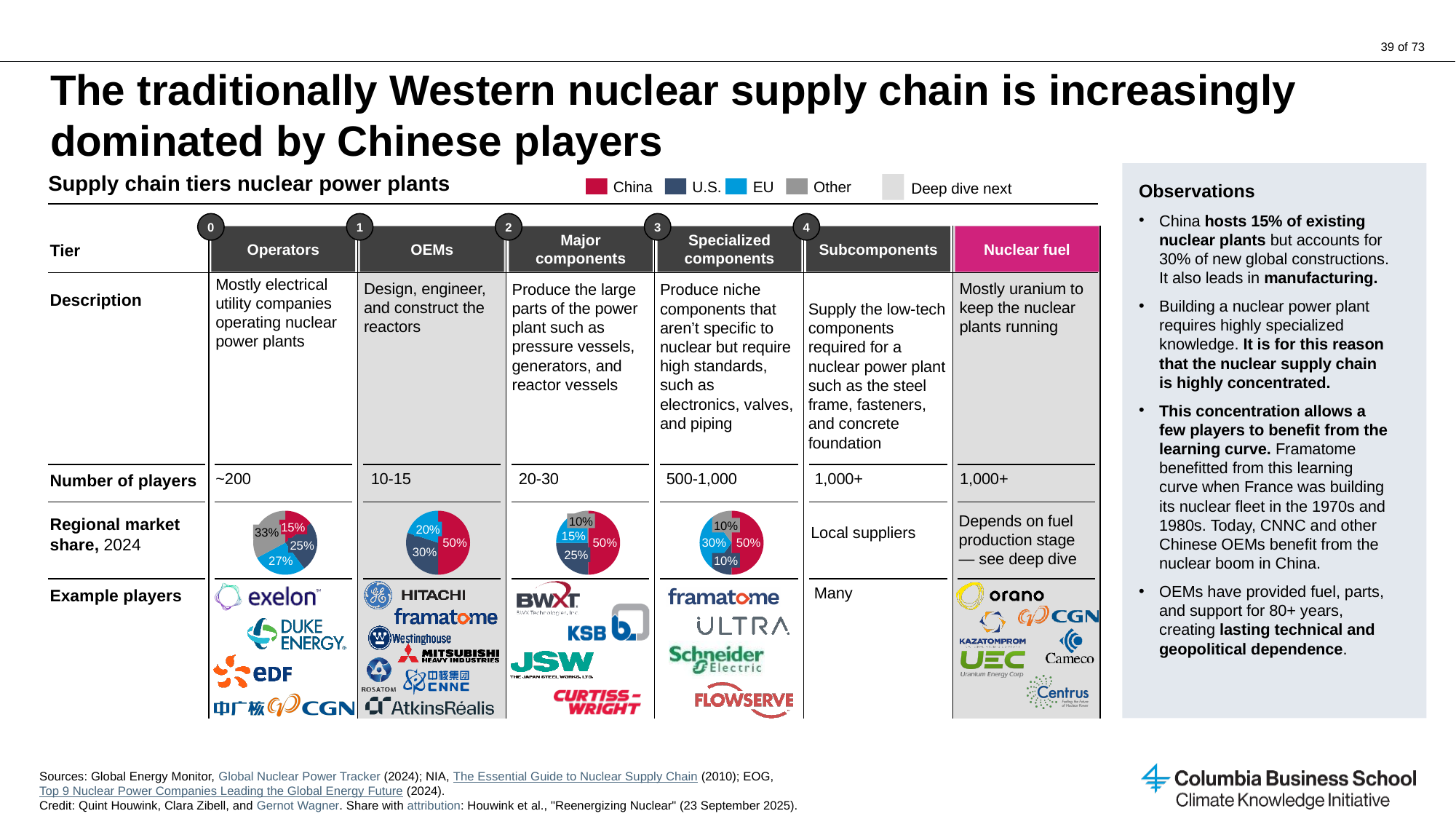
In the OEMs regional market share pie chart, what is the difference between the U.S. share and the EU share? 10% In the Major components regional market share pie chart, what share does the U.S. hold? 25% In the Specialized components regional market share pie chart, is the share for China larger or smaller than the share for the EU? larger In the Operators regional market share pie chart, what share does the EU hold? 27% How many slices does the OEMs regional market share pie chart have? 3 How many regions does the legend for the regional market share charts list? 4 What type of chart is used to show regional market share on this slide? Pie chart In the Specialized components regional market share pie chart, what share does the EU hold? 30% In the Operators regional market share pie chart, what share does China hold? 15% In the OEMs regional market share pie chart, what share does China hold? 50% In the Major components regional market share pie chart, which region has the smallest share? Other In the Operators regional market share pie chart, which region has the largest share? Other